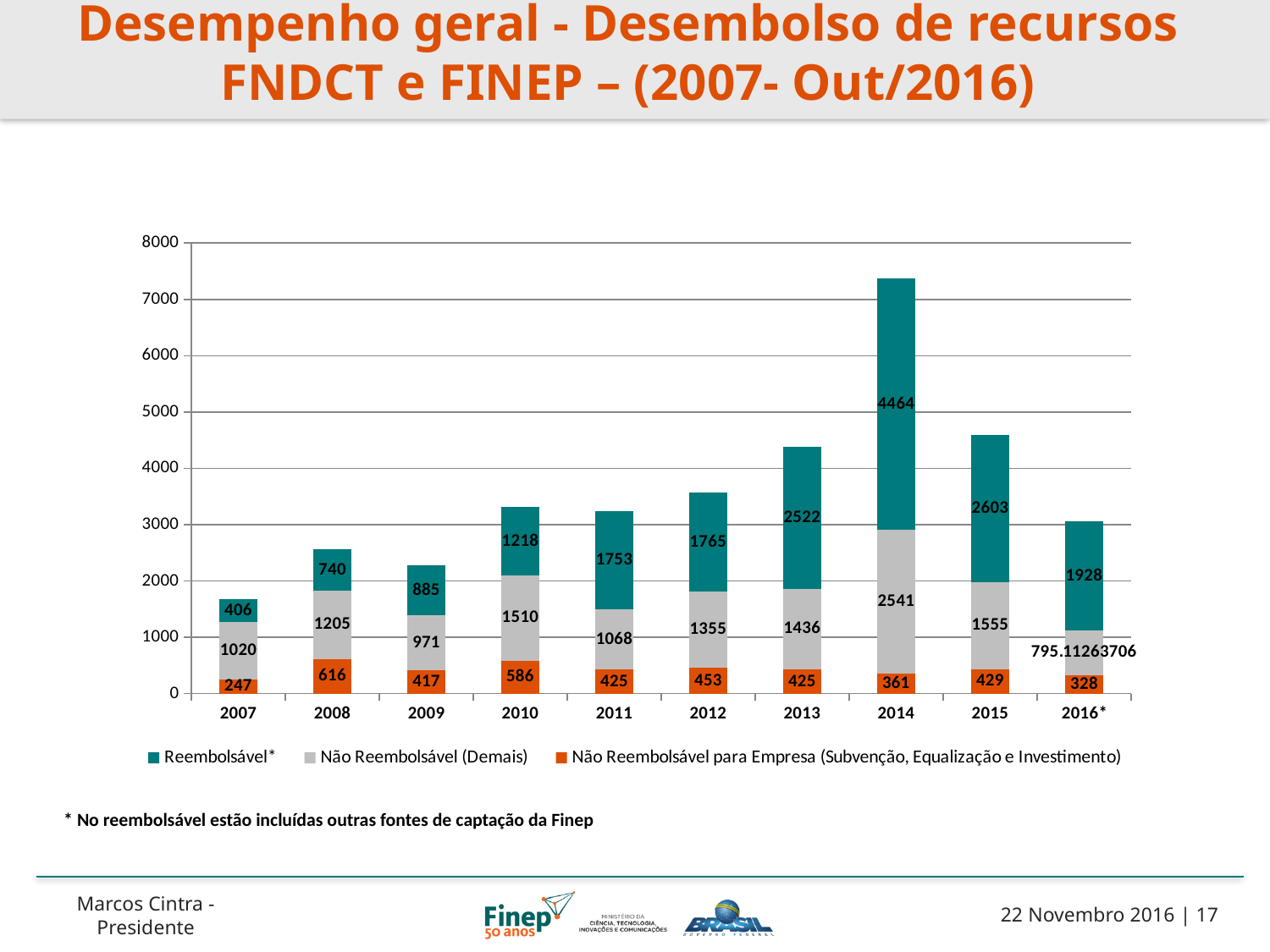
How many series does the legend list? 3 What is the total of the stacked bar for 2007? 1673 What is the difference between the Reembolsável* values for 2015 and 2013? 81 What type of chart is shown on the slide? Stacked bar chart Which year has the highest Reembolsável* value? 2014 Which year has the lowest Não Reembolsável para Empresa (Subvenção, Equalização e Investimento) value? 2007 What is the Não Reembolsável para Empresa (Subvenção, Equalização e Investimento) value for 2008? 616 Is the total of the stacked bar for 2014 greater or less than 7000? greater Which is larger, the Não Reembolsável (Demais) value for 2012 or for 2013? 2013 What is the Reembolsável* value for 2014? 4464 How many years are shown on the x axis? 10 What is the Não Reembolsável (Demais) value for 2010? 1510